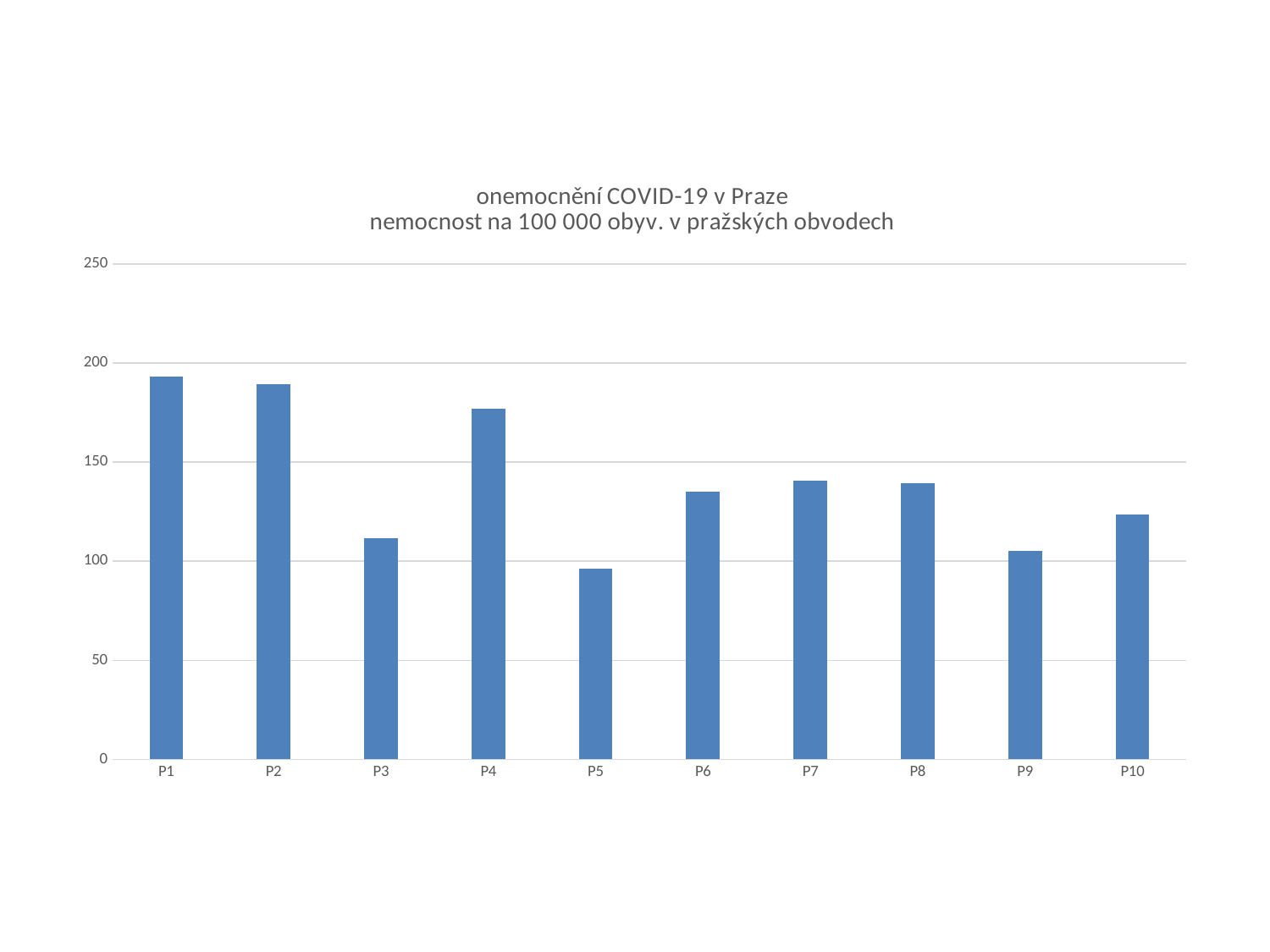
Is the value for P1 greater or less than 150? greater Is the value for P4 greater or less than 150? greater Which district has the lowest value? P5 Is the value for P3 greater or less than 150? less What is the first line of the chart title? onemocnění COVID-19 v Praze Which is larger, the value for P2 or the value for P5? P2 Which is larger, the value for P4 or the value for P3? P4 What kind of chart is shown on the slide? bar chart Which is larger, the value for P6 or the value for P10? P6 How many Prague districts (categories) are shown on the x axis? 10